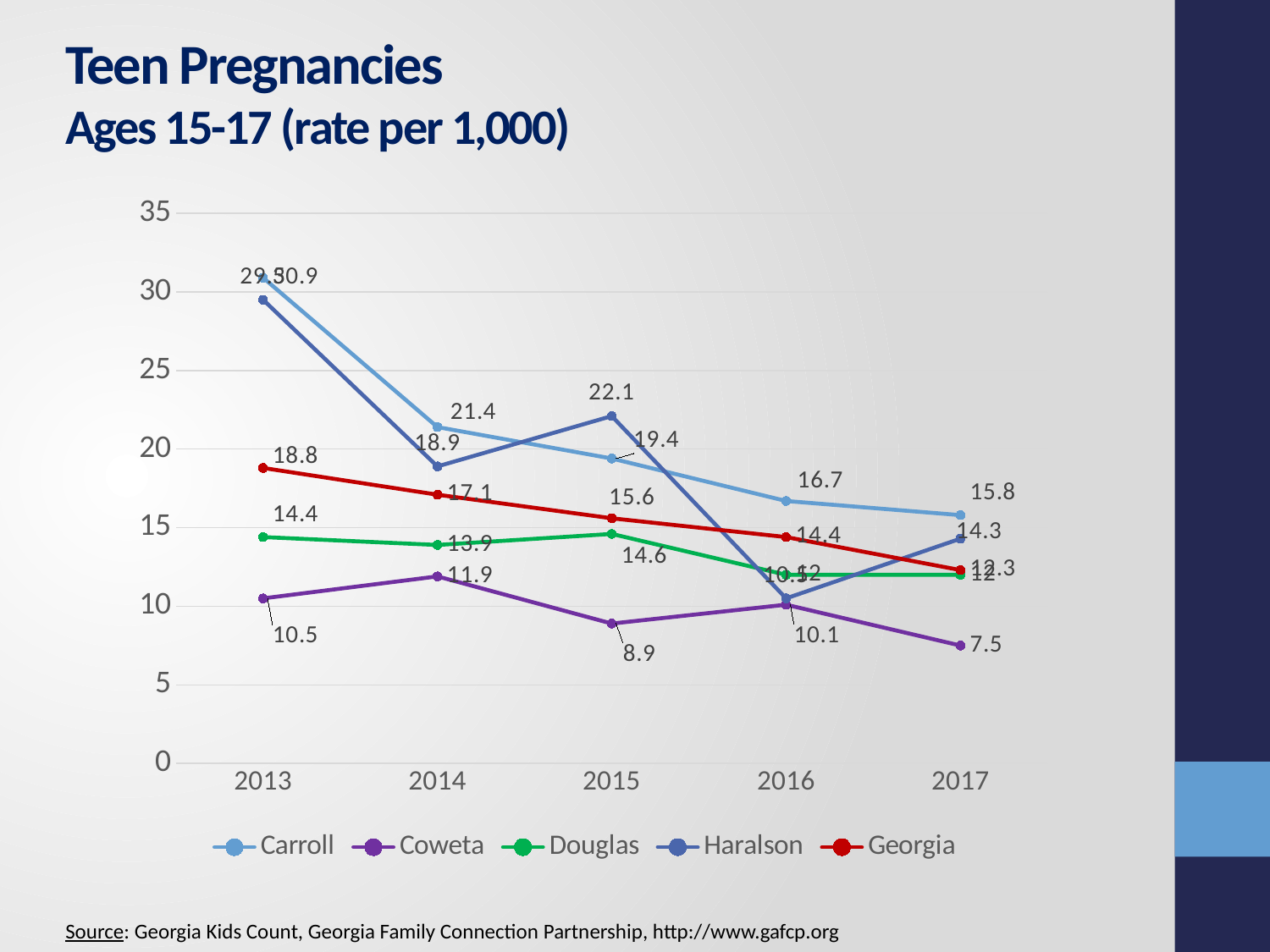
What kind of chart is shown? line chart What is the Carroll rate in 2013? 30.9 What is the Georgia rate in 2014? 17.1 How many series does the legend list? 5 What is the Haralson rate in 2015? 22.1 In which year is the Coweta rate lowest? 2017 By how much did the Carroll rate fall from 2013 to 2017? 15.1 In 2015, which is higher, Haralson or Carroll? Haralson What is the Douglas rate in 2015? 14.6 Does the Georgia rate rise or fall from 2013 to 2017? fall In which year is the Carroll rate highest? 2013 What is the Coweta rate in 2017? 7.5